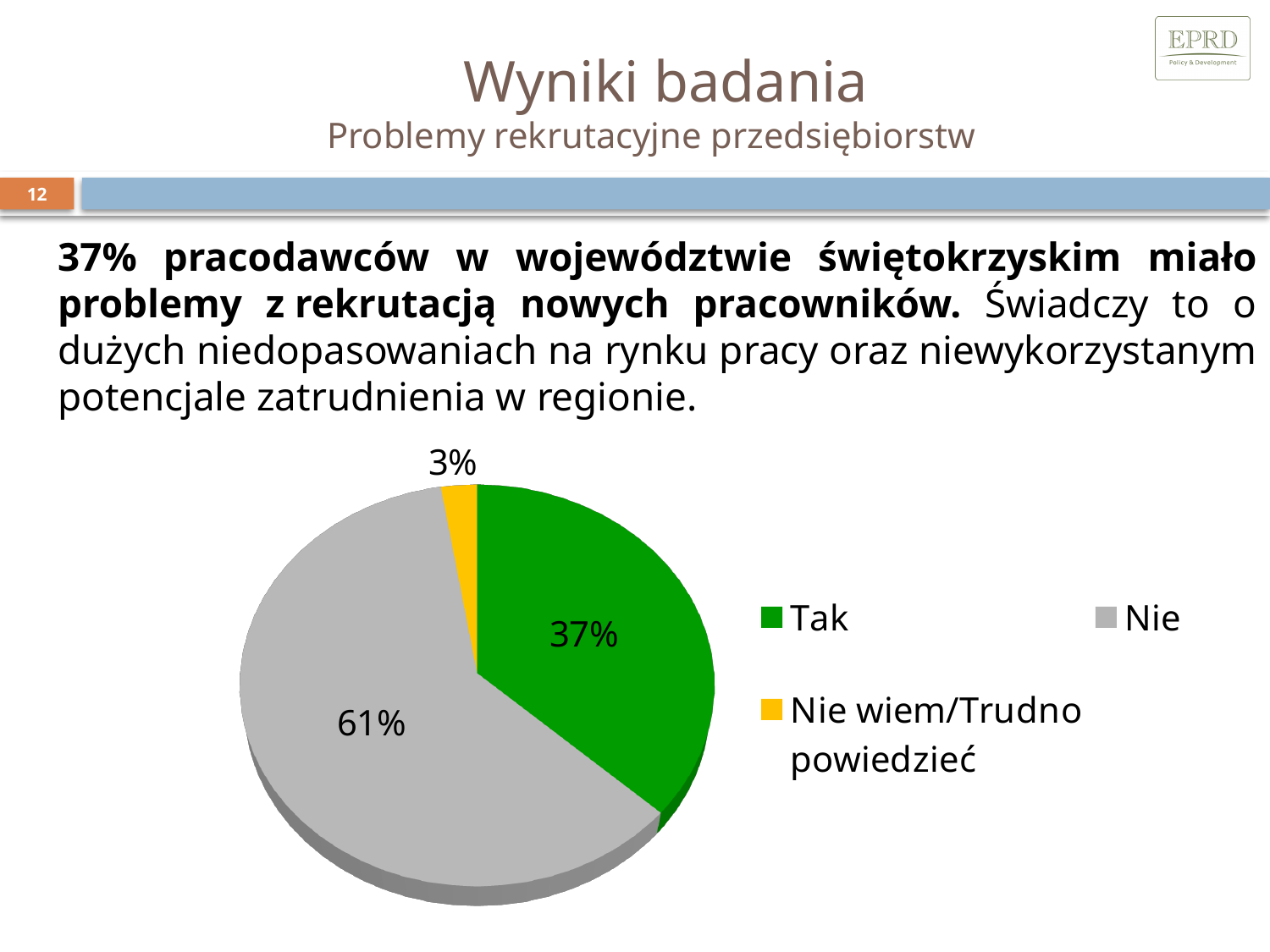
Which category has the largest slice of the pie? Nie What is the difference in percentage points between the "Nie" and "Tak" slices? 24 What share of the pie does the "Nie" slice represent? 61% What kind of chart is shown on the slide? Pie chart Which slice is larger, "Tak" or "Nie"? Nie What colour is the "Nie wiem/Trudno powiedzieć" slice in the pie chart? Yellow What share of the pie does the "Tak" slice represent? 37% Which category has the smallest slice of the pie? Nie wiem/Trudno powiedzieć How many entries does the legend list? 3 What share of the pie does the "Nie wiem/Trudno powiedzieć" slice represent? 3% How many slices does the pie chart have? 3 What colour is the "Tak" slice in the pie chart? Green